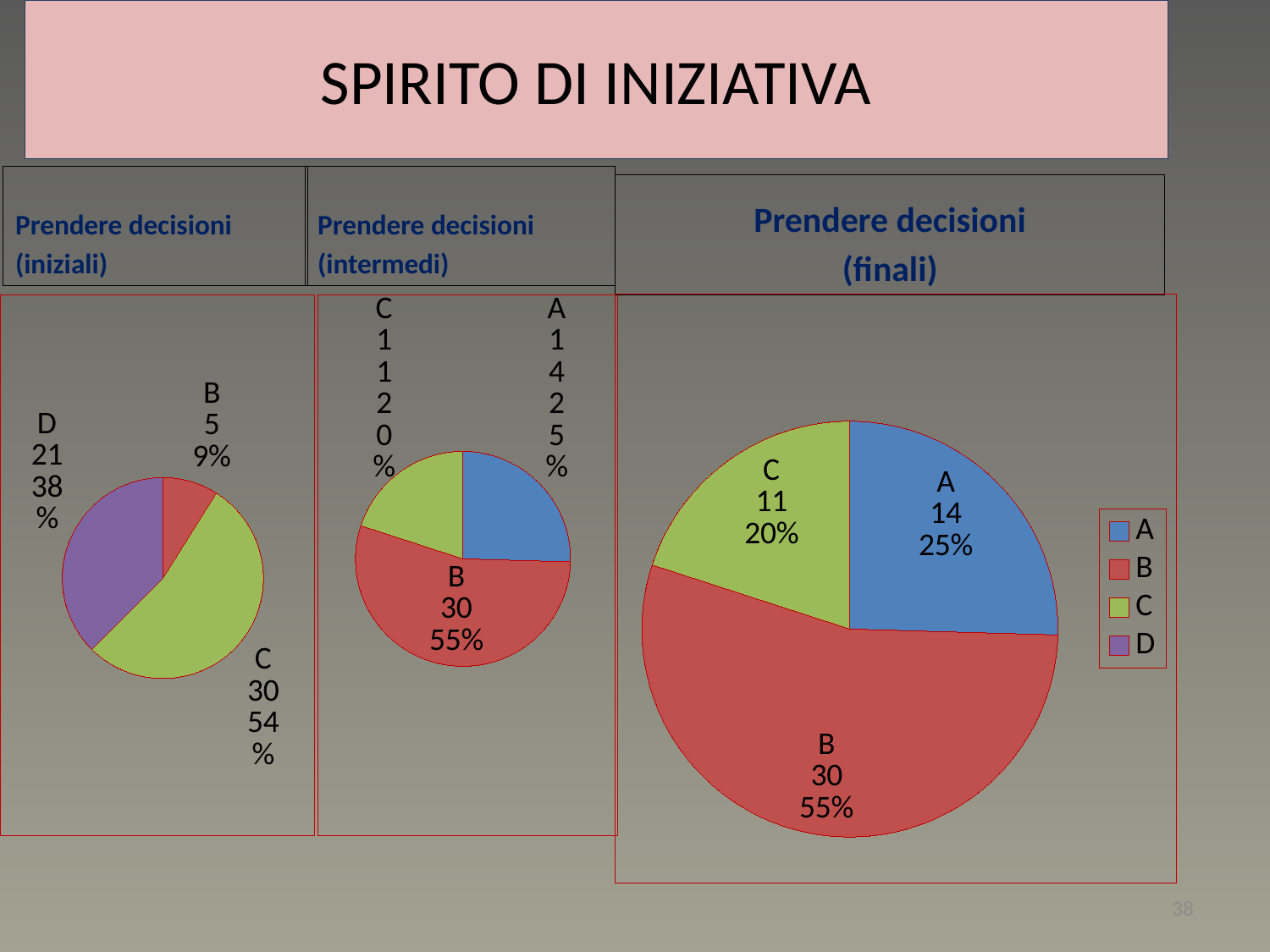
In the 'Prendere decisioni (iniziali)' chart, which category has the smallest slice? B In the 'Prendere decisioni (finali)' chart, what value is shown for B? 30 In the 'Prendere decisioni (iniziali)' chart, what value is shown for D? 21 In the 'Prendere decisioni (iniziali)' chart, which category has the largest slice? C In the 'Prendere decisioni (finali)' chart, which is larger, the value for A or the value for C? A How many entries does the legend next to the 'Prendere decisioni (finali)' chart list? 4 In the 'Prendere decisioni (intermedi)' chart, what value is shown for A? 14 In the 'Prendere decisioni (intermedi)' chart, what is the difference between the values for B and C? 19 What type of chart is 'Prendere decisioni (finali)'? Pie chart How many slices does the 'Prendere decisioni (iniziali)' pie chart have? 3 In the 'Prendere decisioni (finali)' chart, what percentage share does slice C have? 20% In the 'Prendere decisioni (iniziali)' chart, what percentage share does slice D have? 38%